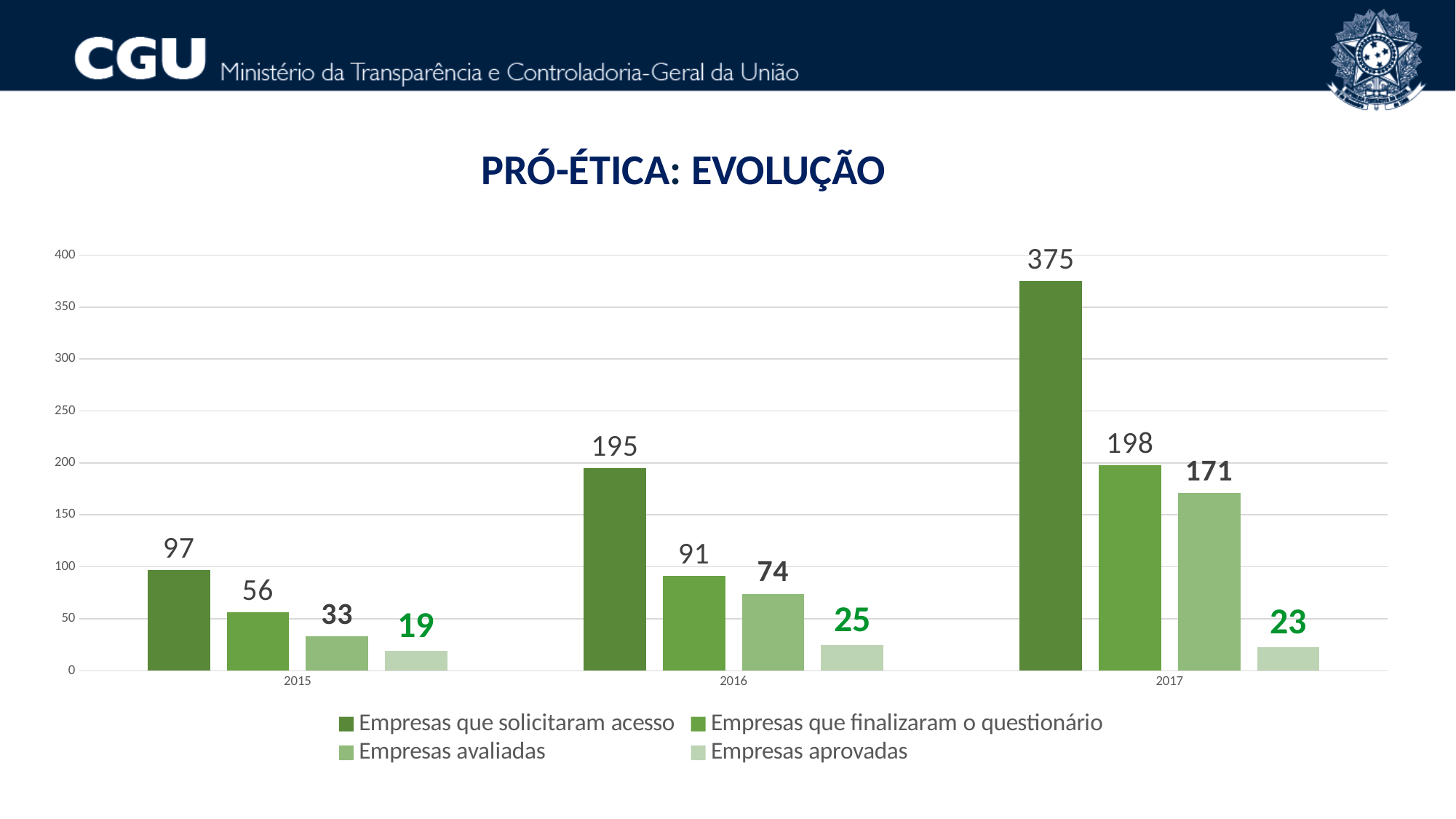
How many years are shown on the x axis? 3 Does 'Empresas avaliadas' rise or fall from 2015 to 2017? Rise Which is larger: 'Empresas avaliadas' in 2017 or 'Empresas que finalizaram o questionário' in 2016? Empresas avaliadas in 2017 What kind of chart is shown on the slide? Bar chart What is the value for 'Empresas avaliadas' in 2016? 74 In which year is 'Empresas aprovadas' lowest? 2015 In which year is 'Empresas que solicitaram acesso' highest? 2017 How many series does the legend list? 4 What is the value for 'Empresas aprovadas' in 2015? 19 What is the value for 'Empresas que solicitaram acesso' in 2017? 375 What is the value for 'Empresas que finalizaram o questionário' in 2017? 198 What is the difference between 'Empresas que solicitaram acesso' and 'Empresas que finalizaram o questionário' in 2017? 177